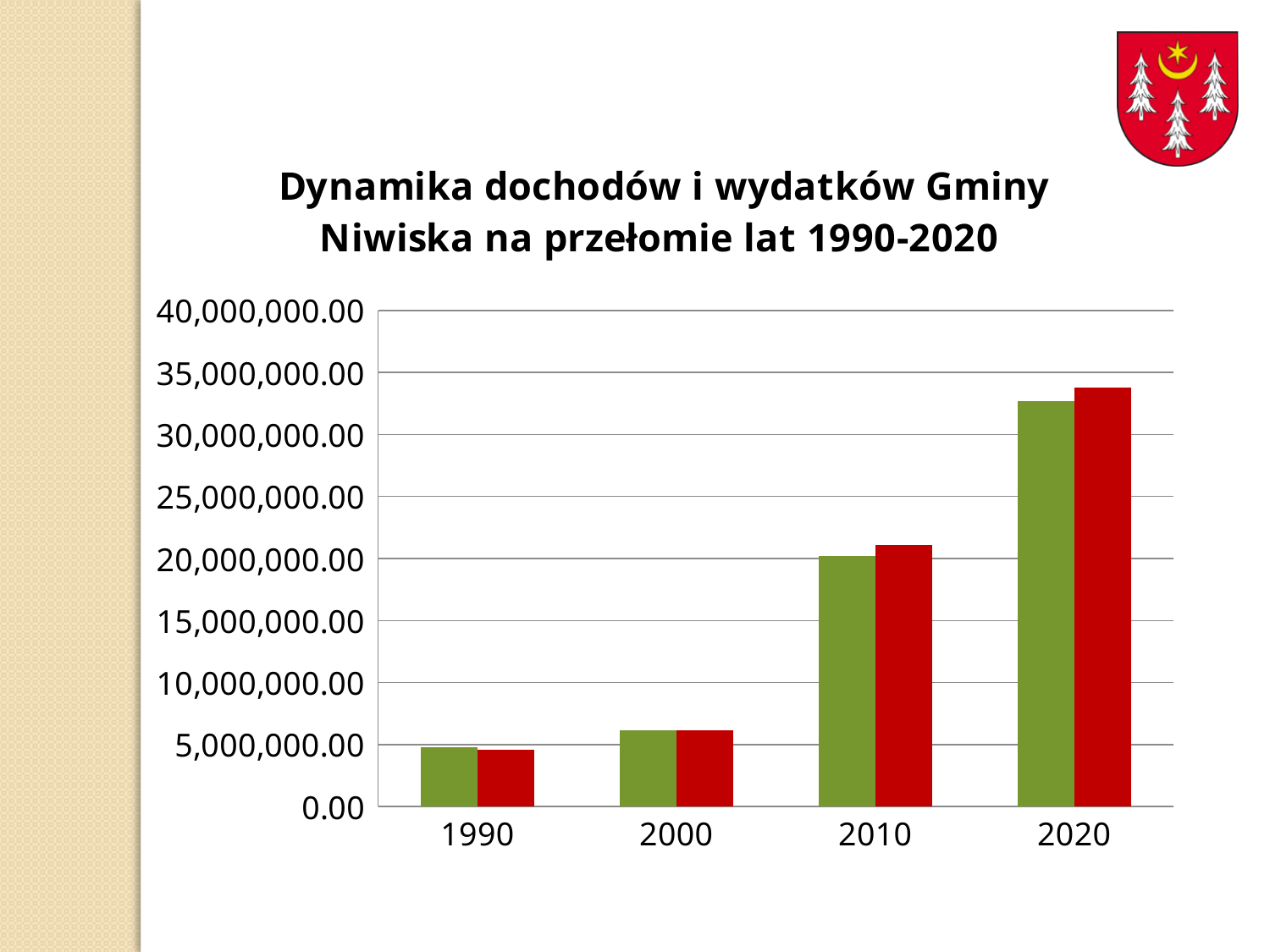
What is the title of the chart? Dynamika dochodów i wydatków Gminy Niwiska na przełomie lat 1990-2020 Which year has the highest green bar? 2020 Do the values of the green bars rise or fall from 1990 to 2020? rise What kind of chart is shown on the slide? bar chart Is the value of the green bar for 2000 greater or less than 5,000,000.00? greater Is the value of the red bar for 2020 greater or less than 35,000,000.00? less Is the value of the red bar for 2010 greater or less than 20,000,000.00? greater For 2020, which bar is taller, the green one or the red one? the red one Which year has the lowest red bar? 1990 How many bars are plotted for each year in the chart? 2 How many years are shown on the x axis of the chart? 4